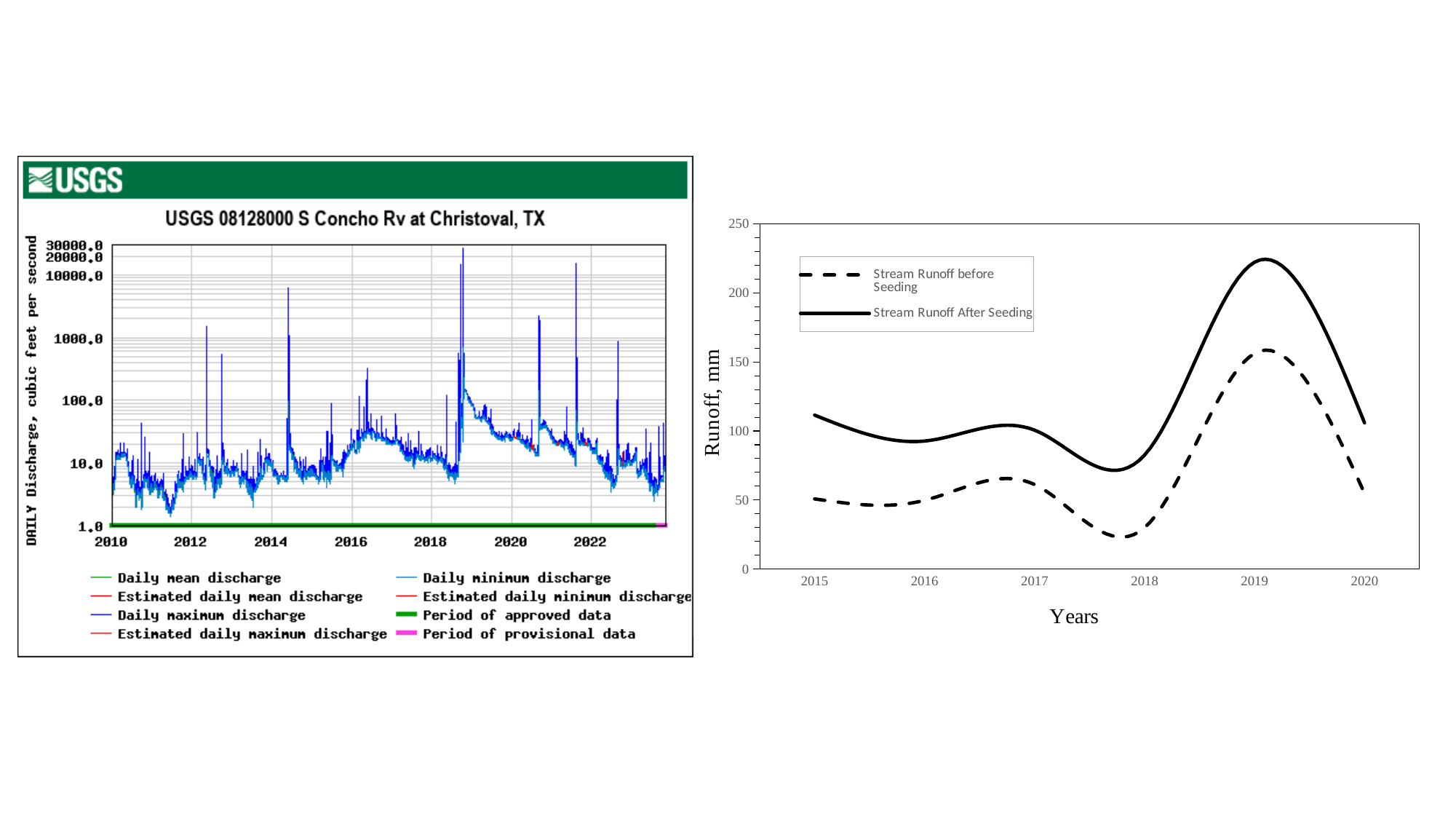
In the right-hand runoff chart, how many years are marked on the x axis? 6 In the right-hand runoff chart, does Stream Runoff After Seeding rise or fall from 2019 to 2020? fall In the right-hand runoff chart, is the value for Stream Runoff before Seeding in 2018 greater or less than 50? less In the right-hand runoff chart, in which year is Stream Runoff before Seeding at its lowest? 2018 In the right-hand runoff chart, which series has the higher value in 2019, Stream Runoff before Seeding or Stream Runoff After Seeding? Stream Runoff After Seeding What type of chart is the chart on the right (Runoff, mm vs Years)? line chart In the right-hand runoff chart, in which year does Stream Runoff After Seeding reach its highest value? 2019 In the right-hand runoff chart, is the value for Stream Runoff After Seeding in 2018 greater or less than 100? less In the right-hand runoff chart, is the value for Stream Runoff After Seeding in 2019 greater or less than 200? greater How many series does the legend of the right-hand runoff chart list? 2 What is the y-axis label of the chart on the right? Runoff, mm What is the title of the chart on the left? USGS 08128000 S Concho Rv at Christoval, TX